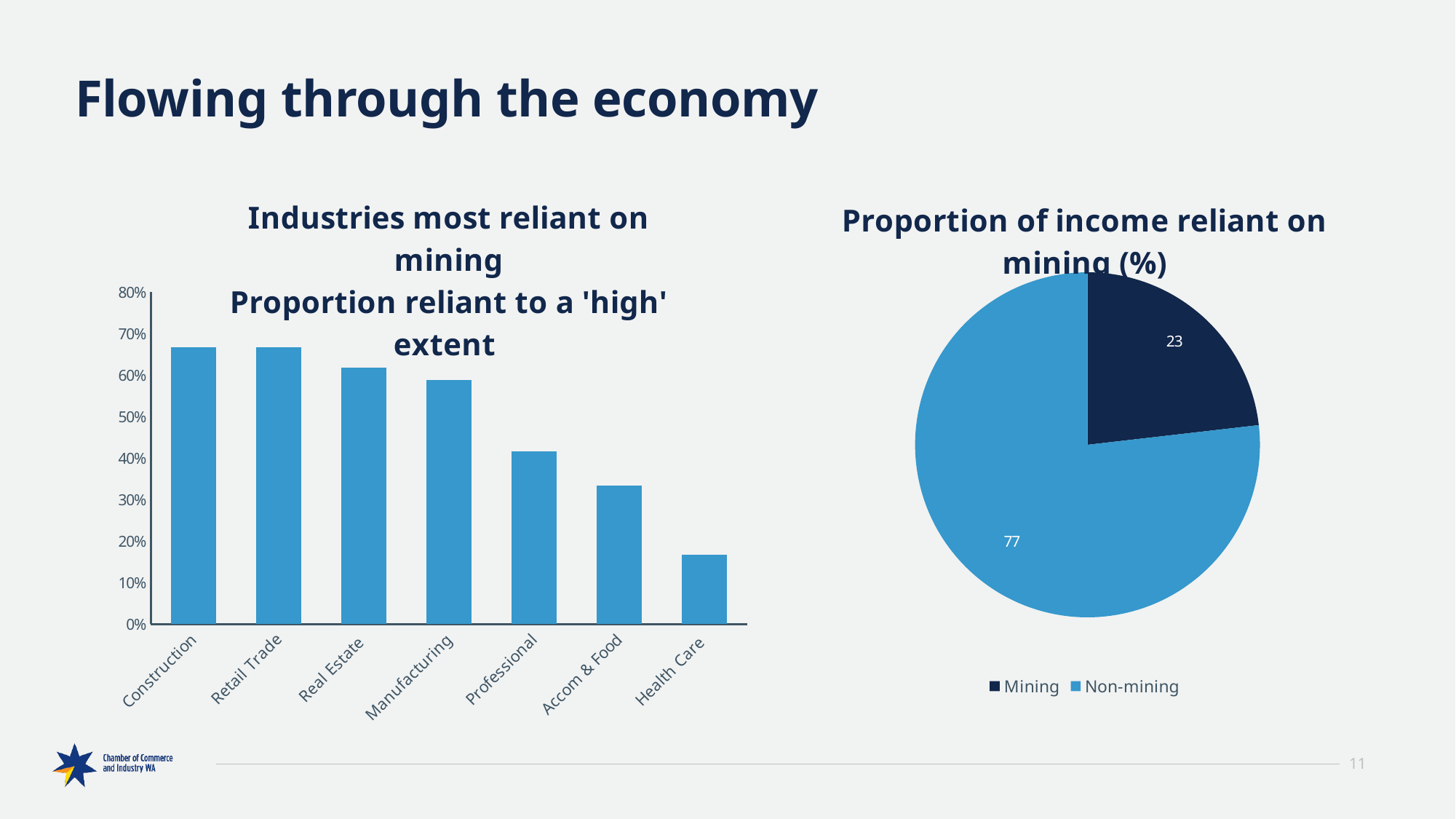
In the 'Industries most reliant on mining' chart, is the value for Accom & Food greater or less than 30%? greater In the 'Proportion of income reliant on mining (%)' chart, what is the value for Mining? 23 In the 'Proportion of income reliant on mining (%)' chart, what is the difference between the Non-mining and Mining values? 54 In the 'Industries most reliant on mining' chart, is the value for Health Care greater or less than 20%? less In the 'Industries most reliant on mining' chart, which is larger, the value for Real Estate or the value for Professional? Real Estate What kind of chart is the 'Industries most reliant on mining' chart? bar chart In the 'Industries most reliant on mining' chart, is the value for Professional greater or less than 40%? greater How many entries does the legend of the 'Proportion of income reliant on mining (%)' chart list? 2 How many industries are shown in the 'Industries most reliant on mining' bar chart? 7 In the 'Industries most reliant on mining' chart, which industry has the lowest proportion reliant to a 'high' extent? Health Care In the 'Proportion of income reliant on mining (%)' chart, what is the value for Non-mining? 77